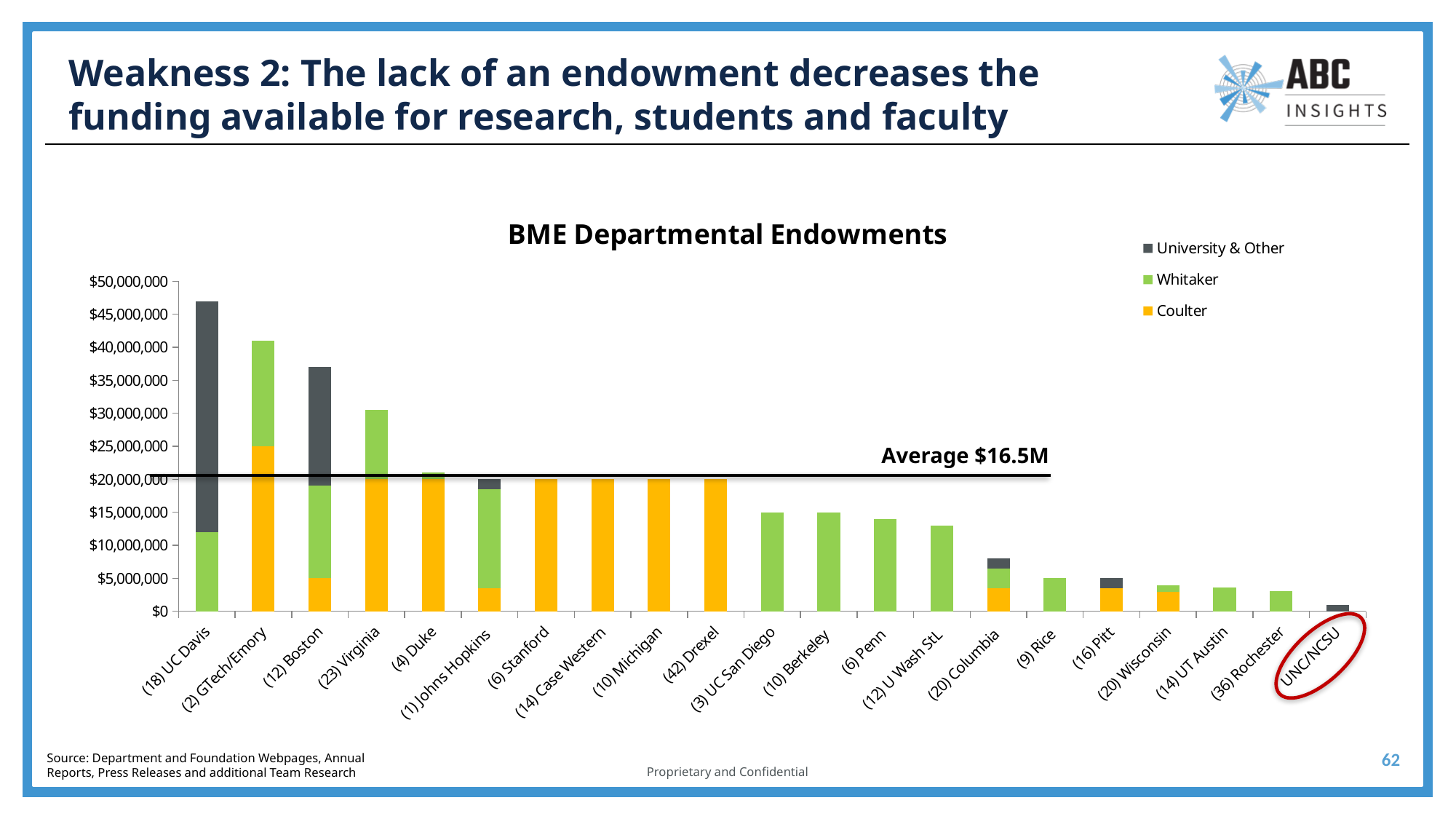
Is the total endowment for (36) Rochester greater or less than $5,000,000? less Is the total endowment for (18) UC Davis greater or less than $45,000,000? greater Which has the larger total endowment, (18) UC Davis or (12) Boston? (18) UC Davis What is the title of the chart? BME Departmental Endowments What average value is labelled on the horizontal line across the chart? Average $16.5M How many series does the legend list? 3 Which institution has the lowest total endowment in the chart? UNC/NCSU Which institution has the highest total endowment in the chart? (18) UC Davis What kind of chart is shown on the slide? bar chart What is the total endowment shown for (6) Stanford? $20,000,000 How many institutions are shown on the x axis of the chart? 21 What is the total endowment shown for (9) Rice? $5,000,000